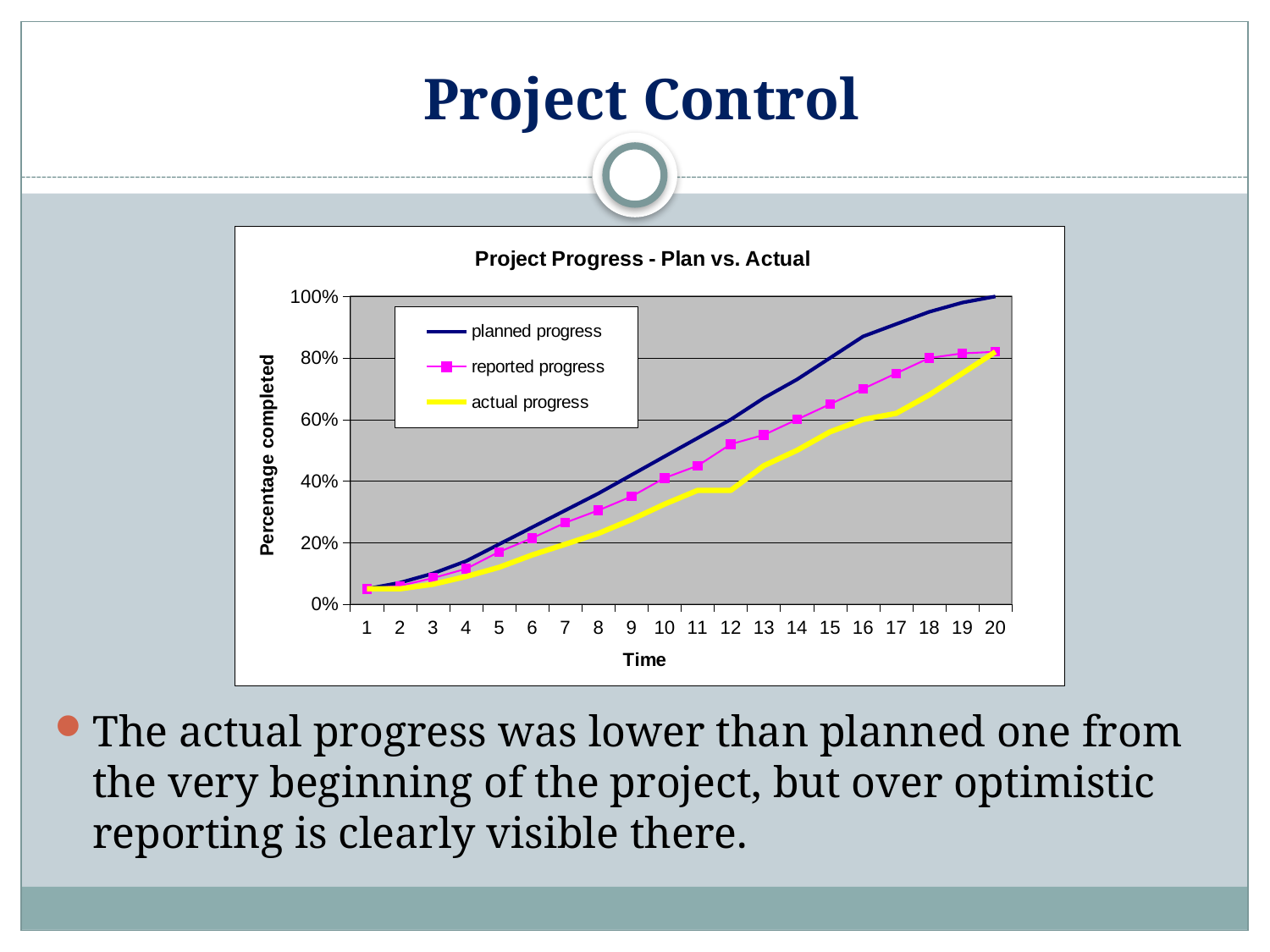
What is the title of the chart? Project Progress - Plan vs. Actual What kind of chart is shown on the slide? line chart Is the value of actual progress at time 10 greater or less than 40%? less Is the value of reported progress at time 12 greater or less than 60%? less At time 15, which is larger: reported progress or actual progress? reported progress How many time points are shown on the x axis? 20 What is the value of planned progress at time 20? 100% Is the value of planned progress at time 10 greater or less than 40%? greater How many series does the legend list? 3 Do the values of actual progress rise or fall as time increases from 1 to 20? rise Which series has the highest value at time 12? planned progress